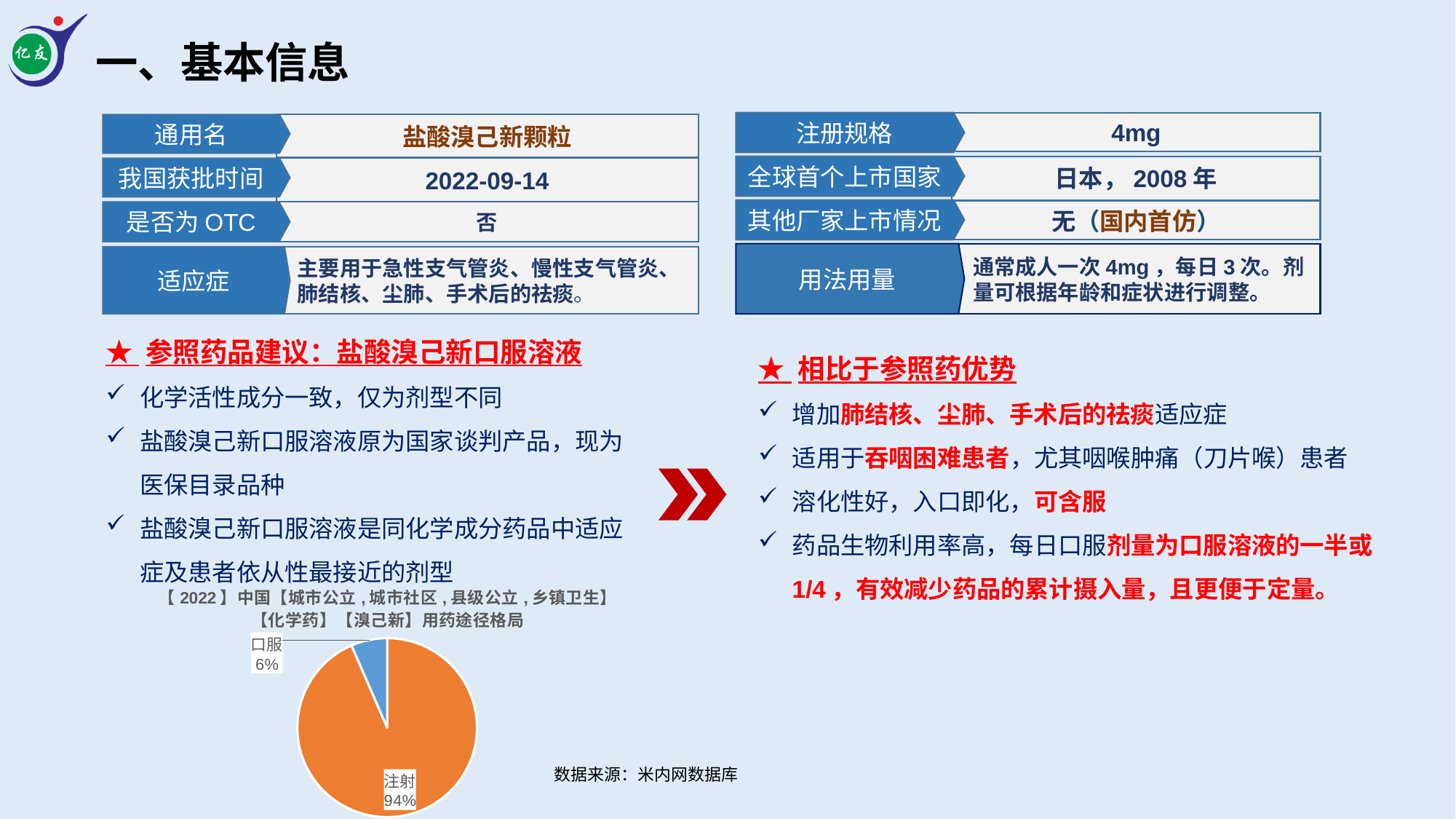
In the pie chart, what share does 口服 (oral) account for? 6% Which route of administration has the smallest share in the pie chart? 口服 By how many percentage points does the 注射 share exceed the 口服 share in the pie chart? 88 Which is larger in the pie chart, the share for 口服 or the share for 注射? 注射 What year does the pie chart's title refer to? 2022 What kind of chart is shown at the bottom left of the slide? Pie chart Which route of administration has the largest share in the pie chart? 注射 How many slices does the pie chart have? 2 What data source is cited for the pie chart? 米内网数据库 Is the share for 注射 in the pie chart greater or less than 50%? greater In the pie chart, what share does 注射 (injection) account for? 94%